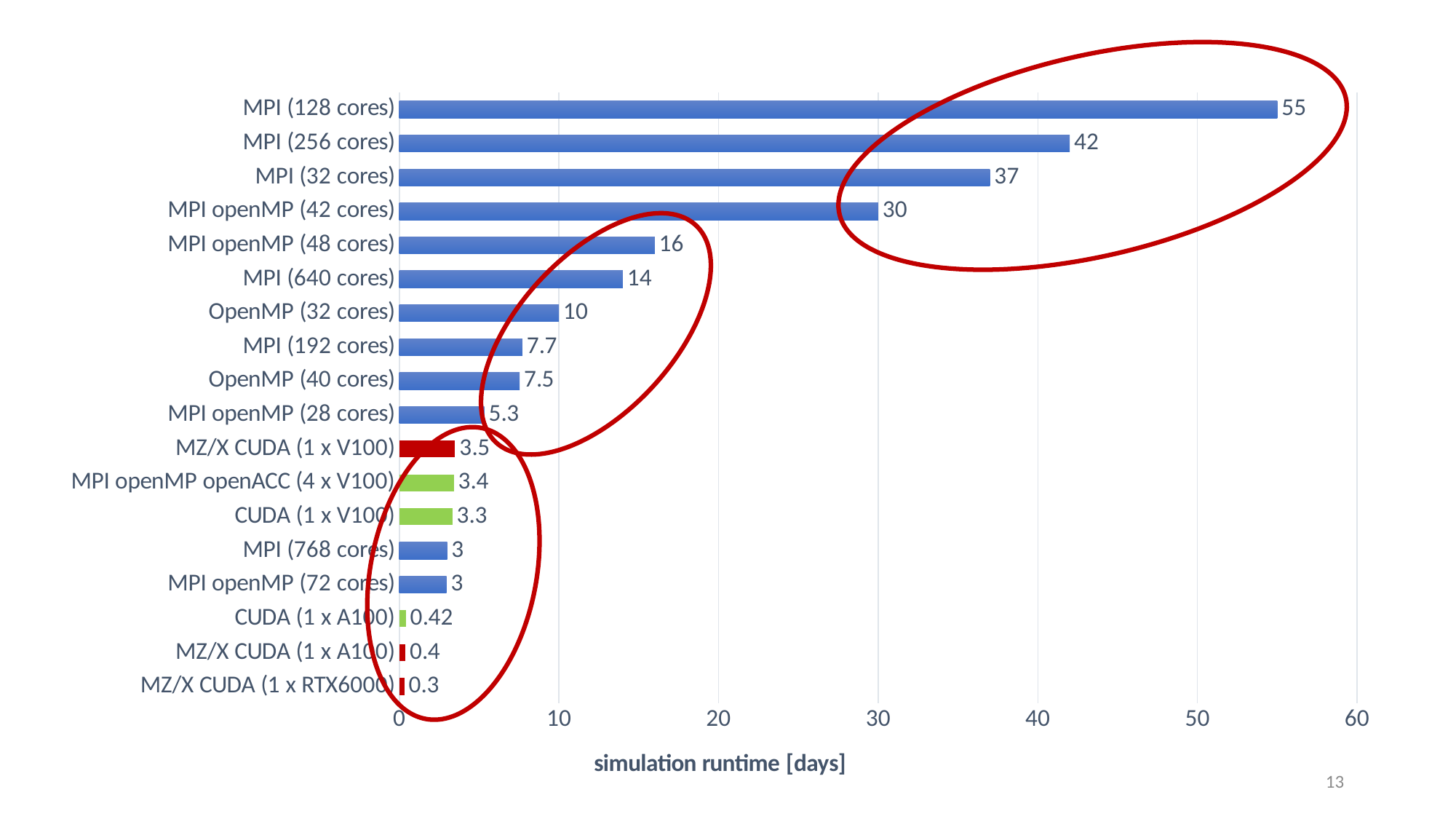
What kind of chart is shown on the slide? Bar chart What is the simulation runtime for MPI (128 cores)? 55 What is the difference in simulation runtime between MPI openMP (48 cores) and MPI (640 cores)? 2 What is the simulation runtime for MZ/X CUDA (1 x V100)? 3.5 How many configurations are plotted in the chart? 18 What is the simulation runtime for CUDA (1 x A100)? 0.42 Which configuration has the highest simulation runtime? MPI (128 cores) Which configuration has the lowest simulation runtime? MZ/X CUDA (1 x RTX6000) Which has a longer simulation runtime, MPI (32 cores) or MPI (640 cores)? MPI (32 cores) What is the simulation runtime for MPI openMP (42 cores)? 30 What is the label of the horizontal axis? simulation runtime [days] What is the difference in simulation runtime between MPI (128 cores) and MPI (256 cores)? 13